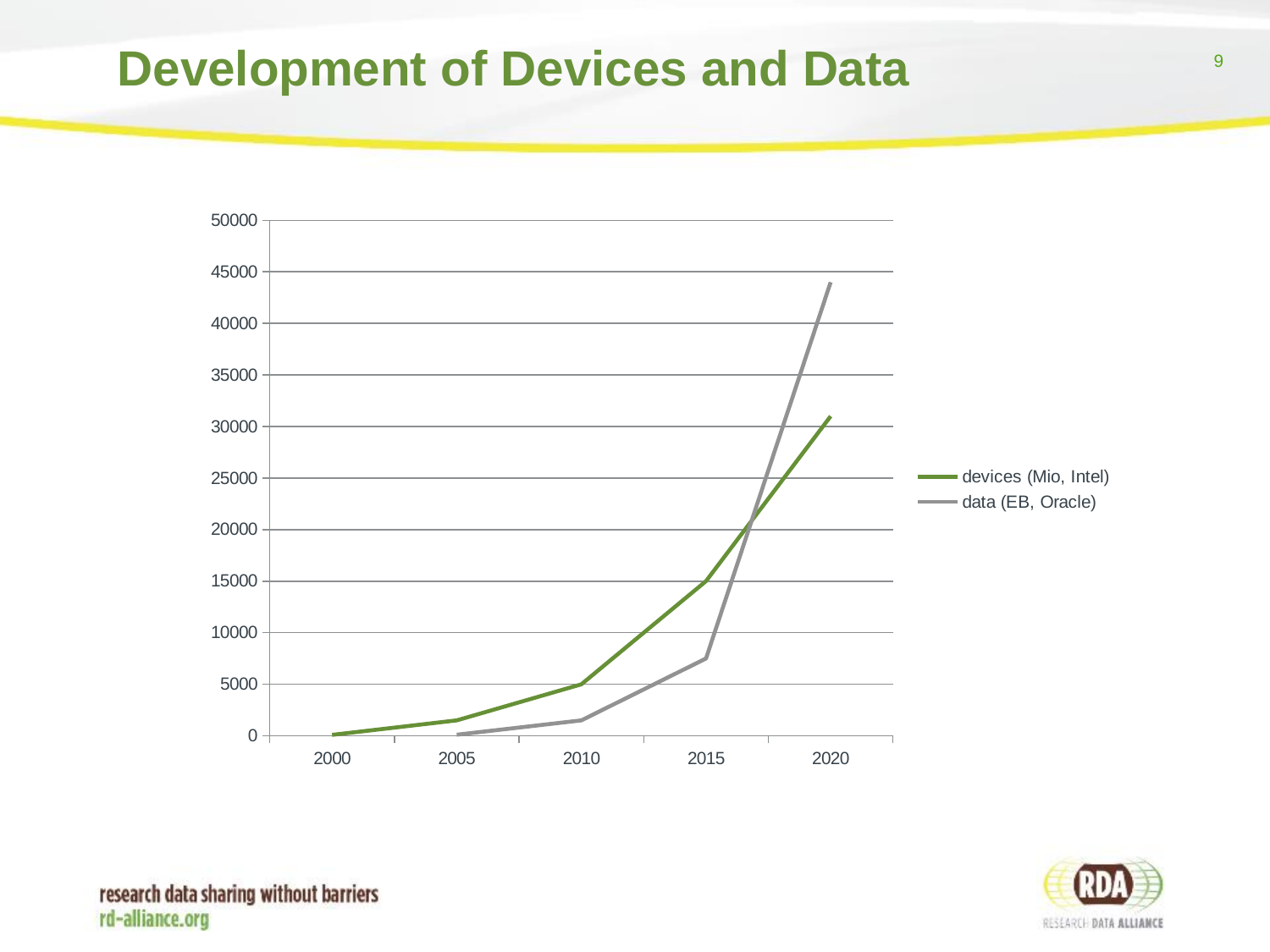
How many series does the legend list? 2 In 2015, which series has the higher value, devices (Mio, Intel) or data (EB, Oracle)? devices (Mio, Intel) Is the value for data (EB, Oracle) in 2015 greater or less than 10000? less How many years are labelled on the x axis? 5 In which year does data (EB, Oracle) reach its highest value? 2020 Is the value for devices (Mio, Intel) in 2020 greater or less than 25000? greater Is the value for data (EB, Oracle) in 2020 greater or less than 40000? greater What colour is the line for devices (Mio, Intel)? green In 2020, which series has the higher value, devices (Mio, Intel) or data (EB, Oracle)? data (EB, Oracle) Do the values for devices (Mio, Intel) rise or fall from 2000 to 2020? rise What kind of chart is shown on the slide? line chart